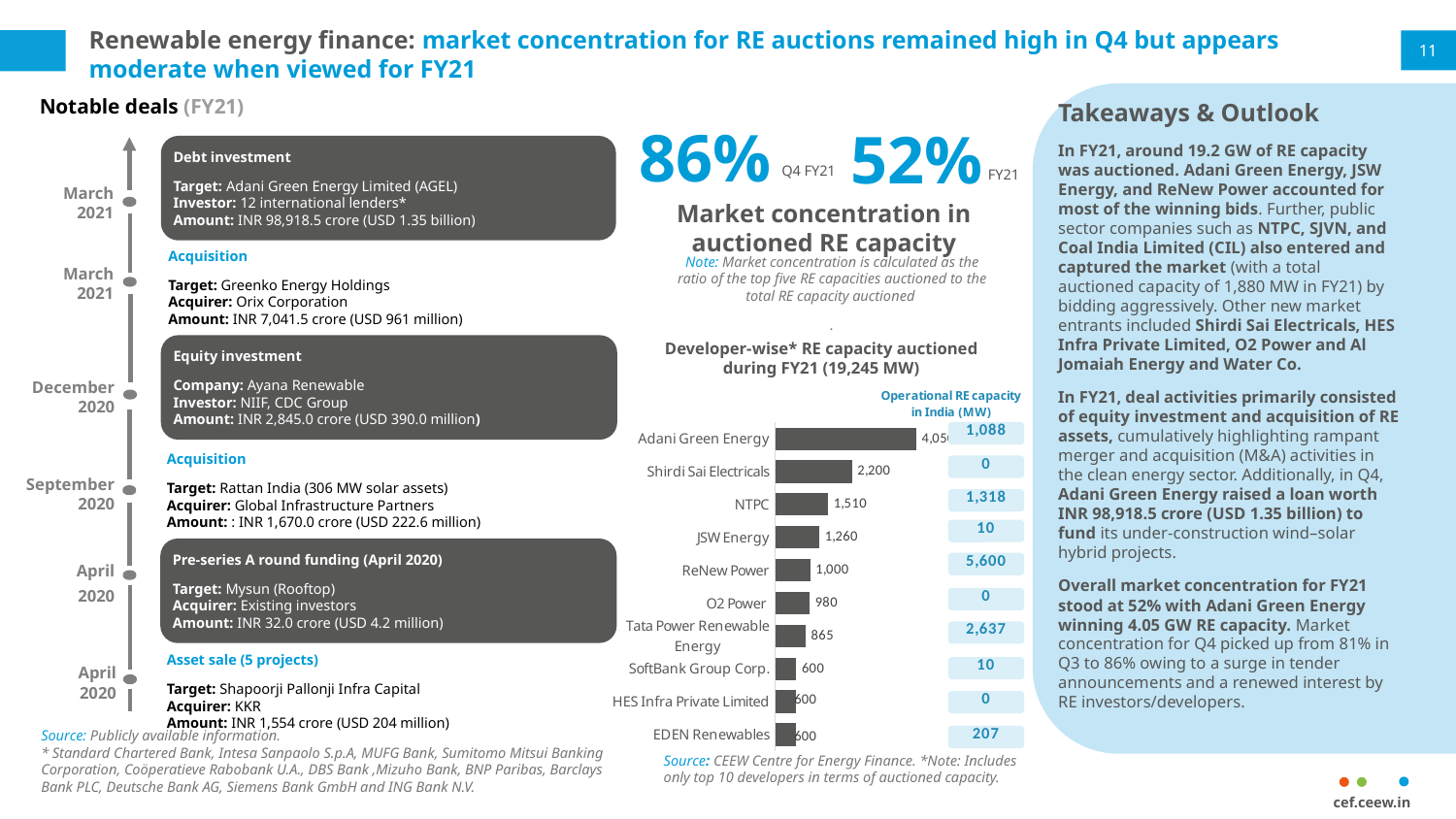
What is the RE capacity auctioned during FY21 for JSW Energy? 1,260 Which developer has a larger RE capacity auctioned during FY21, JSW Energy or ReNew Power? JSW Energy What is the RE capacity auctioned during FY21 for Shirdi Sai Electricals? 2,200 Which developer has the highest RE capacity auctioned during FY21 in the chart? Adani Green Energy What is the difference between the RE capacity auctioned for Shirdi Sai Electricals and NTPC? 690 What is the RE capacity auctioned during FY21 for O2 Power? 980 What kind of chart is used to show developer-wise RE capacity auctioned during FY21? bar chart According to the chart title, what total RE capacity was auctioned during FY21? 19,245 MW What is the RE capacity auctioned during FY21 for Tata Power Renewable Energy? 865 What is the RE capacity auctioned during FY21 for NTPC? 1,510 What is the RE capacity auctioned during FY21 for ReNew Power? 1,000 How many developers are shown in the developer-wise RE capacity auctioned chart? 10